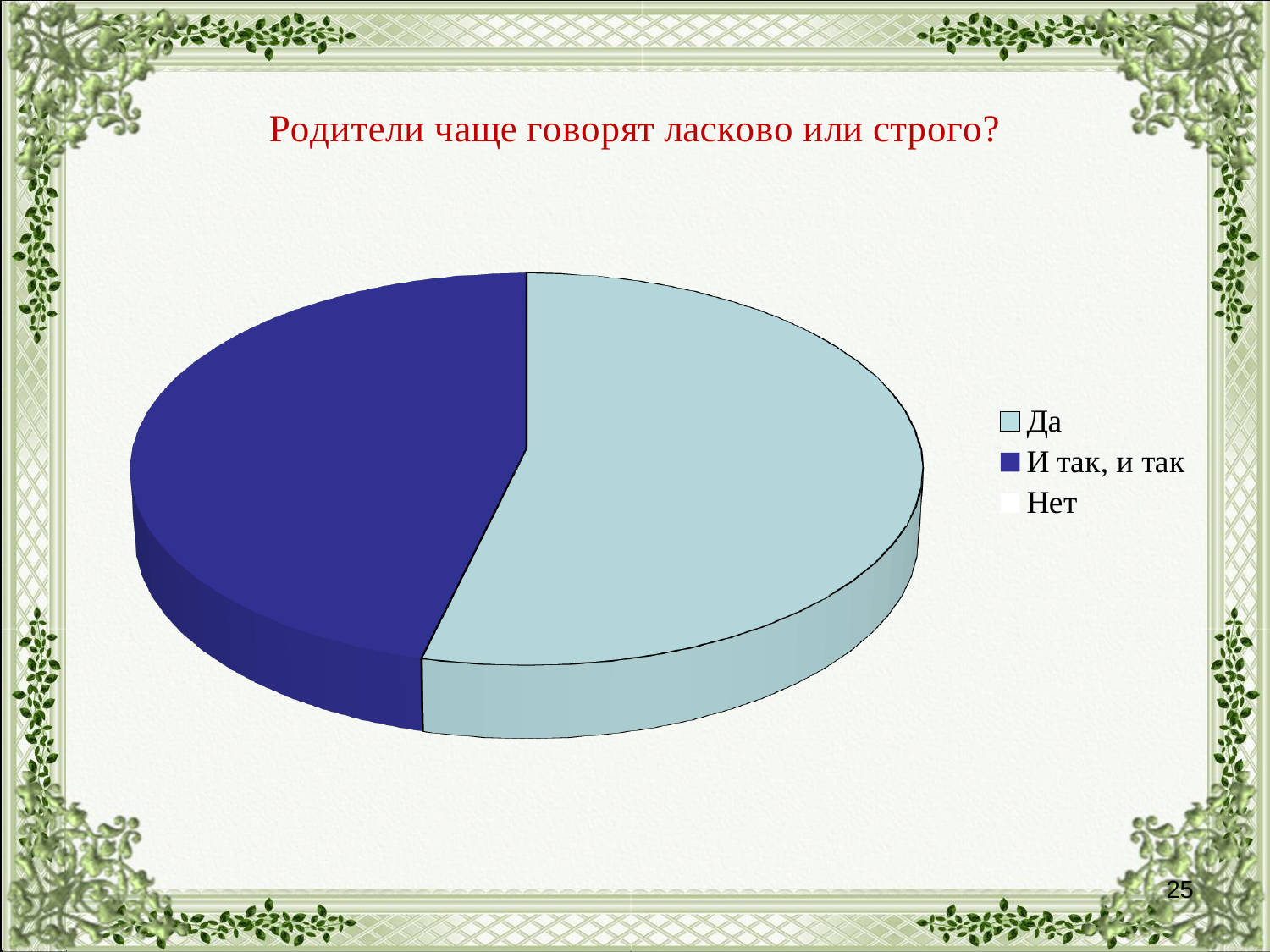
Is the "Да" slice greater or less than half of the pie? greater What is the title of the pie chart? Родители чаще говорят ласково или строго? How many entries does the legend of the pie chart list? 3 What kind of chart is shown on the slide? pie chart Which legend category has no visible slice in the pie chart? Нет What colour is the "Да" slice in the pie chart? light blue Is the "И так, и так" slice greater or less than half of the pie? less Which legend entry is shown in dark blue? И так, и так How many slices are visibly drawn in the pie chart? 2 Which category has the largest slice in the pie chart? Да Which slice of the pie chart is larger, "Да" or "И так, и так"? Да